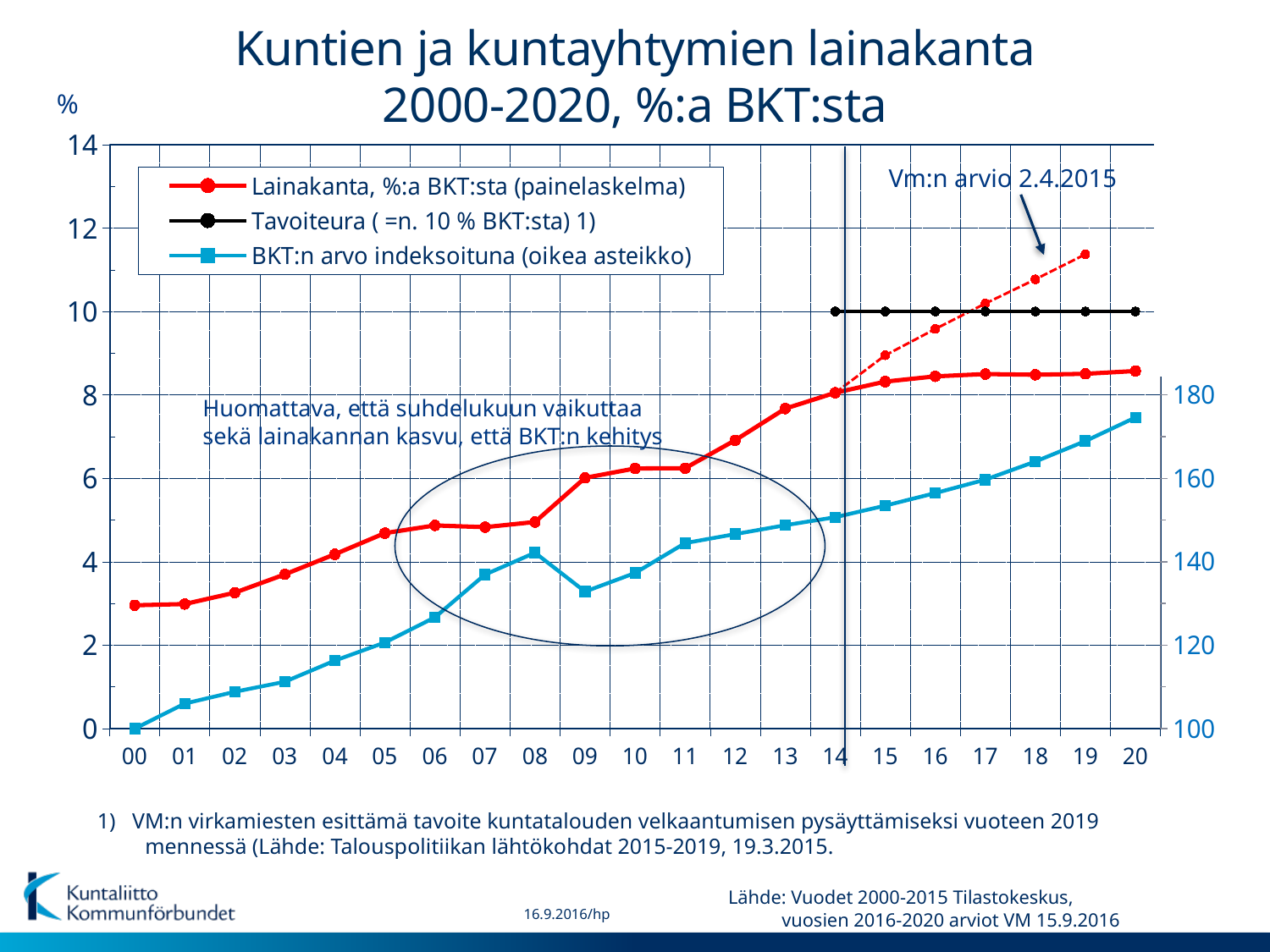
Is the value for BKT:n arvo indeksoituna in 2020 greater or less than 180? less How many years are shown on the x axis? 21 How many series does the legend list? 3 What is the value of the BKT:n arvo indeksoituna series in 2000 on the right axis? 100 Is the value for Lainakanta, %:a BKT:sta in 2013 greater or less than 8? less Is the value for Lainakanta, %:a BKT:sta in 2020 greater or less than 8? greater In which year is the BKT:n arvo indeksoituna series at its lowest? 2000 In 2014, which is larger: Lainakanta, %:a BKT:sta or Tavoiteura? Tavoiteura Does the BKT:n arvo indeksoituna series generally rise or fall from 2000 to 2020? rise What kind of chart is shown on the slide? line chart What is the value of the Tavoiteura series in 2017? 10